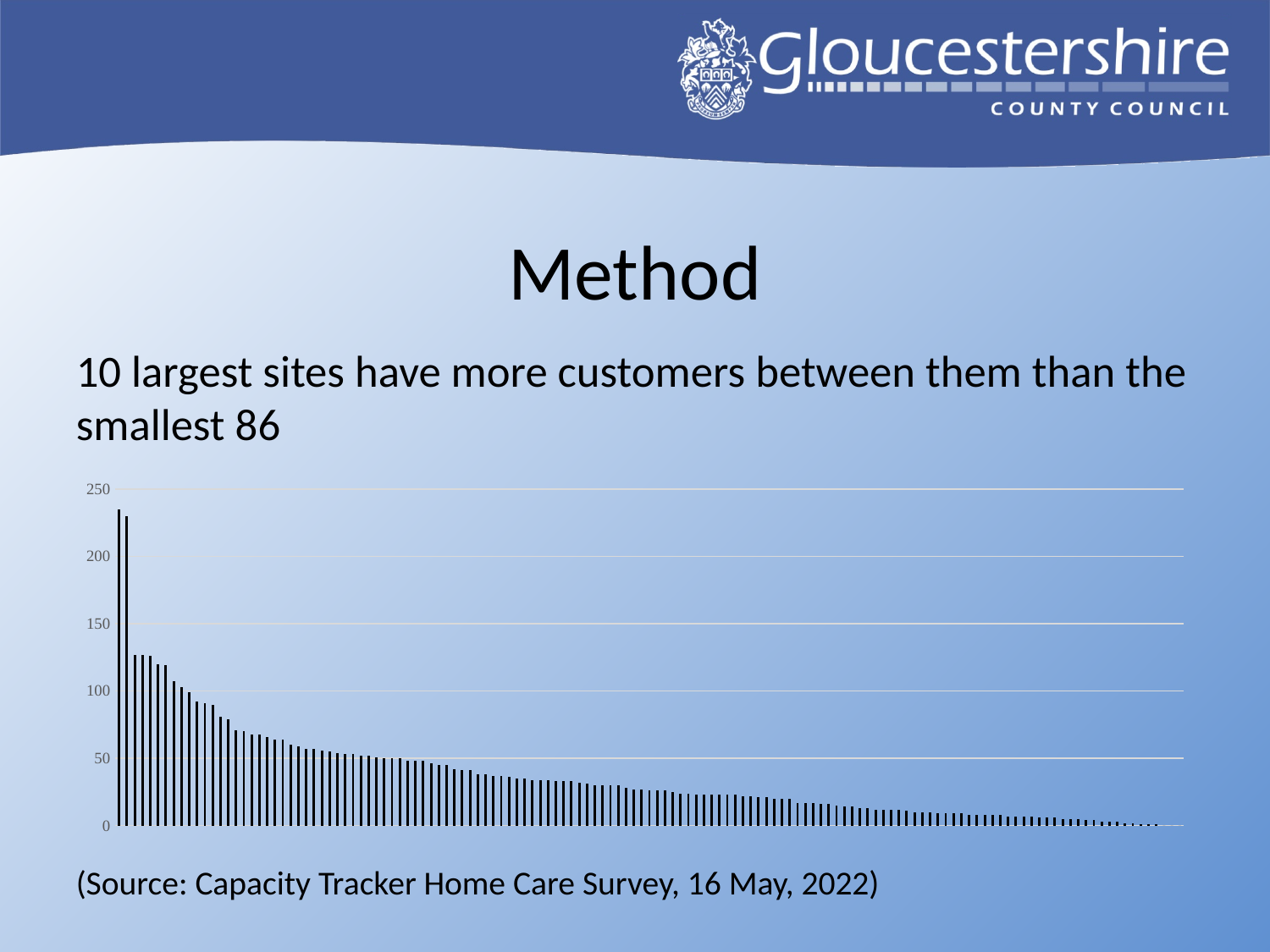
Which bar in the chart is the tallest? the leftmost (first) bar Which is larger, the first bar from the left or the last bar on the right? the first bar from the left Do the bar values rise or fall from left to right across the chart? fall What is the highest value labelled on the vertical axis of the chart? 250 Is the value of the third bar from the left greater or less than 100? greater Is the value of the tallest bar greater or less than 200? greater Is the value of the third bar from the left greater or less than 150? less What kind of chart is shown on the slide? bar chart How many tick labels are shown on the vertical axis of the chart? 6